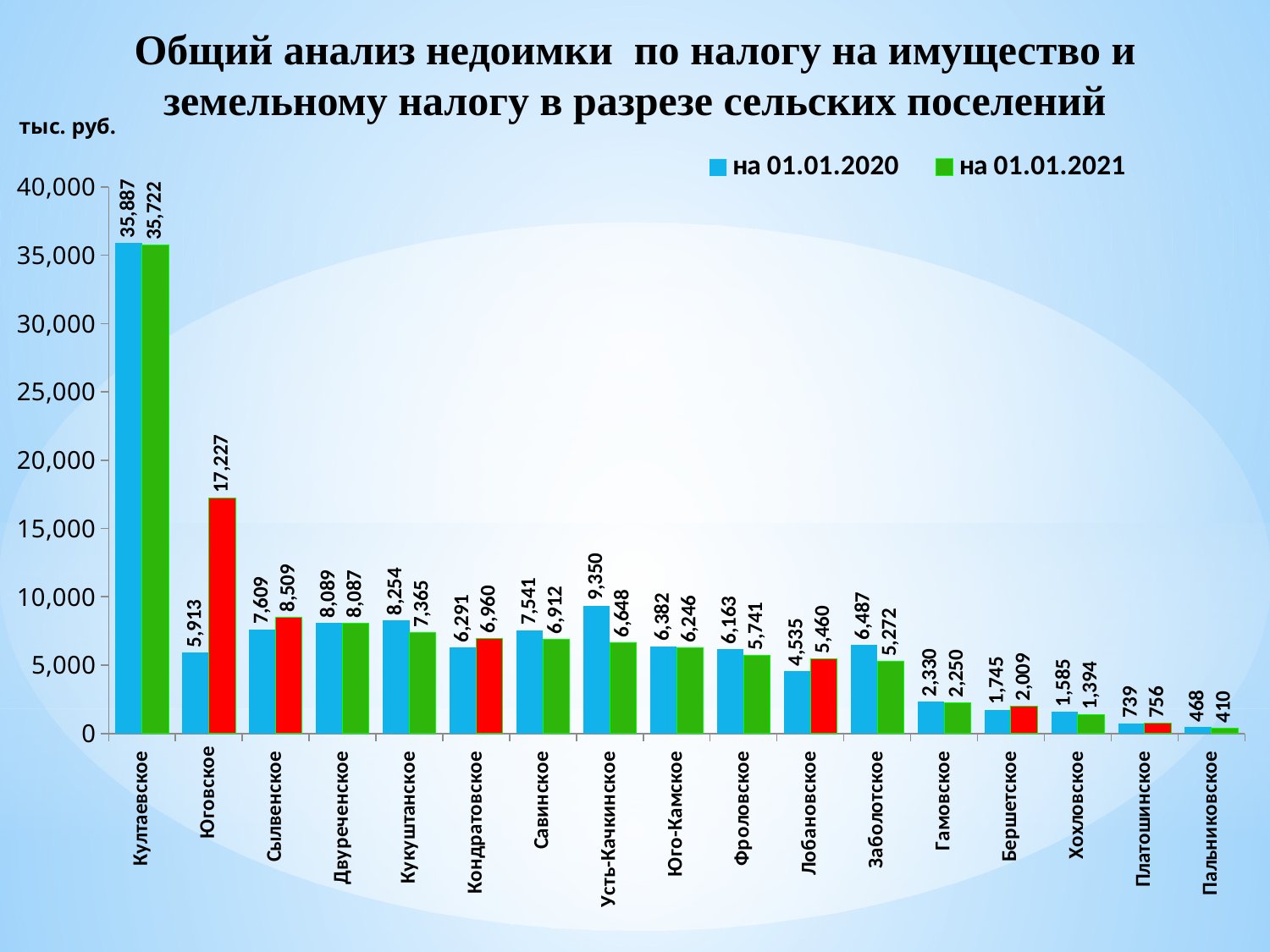
Is the value for Юговское на 01.01.2021 greater or less than 15,000? greater What is the value for Култаевское in the series на 01.01.2020? 35,887 What is the value for Юговское in the series на 01.01.2021? 17,227 For Кукуштанское, which is larger: the value на 01.01.2020 or на 01.01.2021? на 01.01.2020 Which settlement has the highest value in the series на 01.01.2021? Култаевское How many series does the legend list? 2 What is the difference between the на 01.01.2021 and на 01.01.2020 values for Юговское? 11,314 How many settlements are shown on the x axis? 17 What kind of chart is shown on the slide? bar chart What is the value for Усть-Качкинское in the series на 01.01.2020? 9,350 Which settlement has the lowest value in the series на 01.01.2020? Пальниковское What unit of measurement is indicated above the vertical axis? тыс. руб.